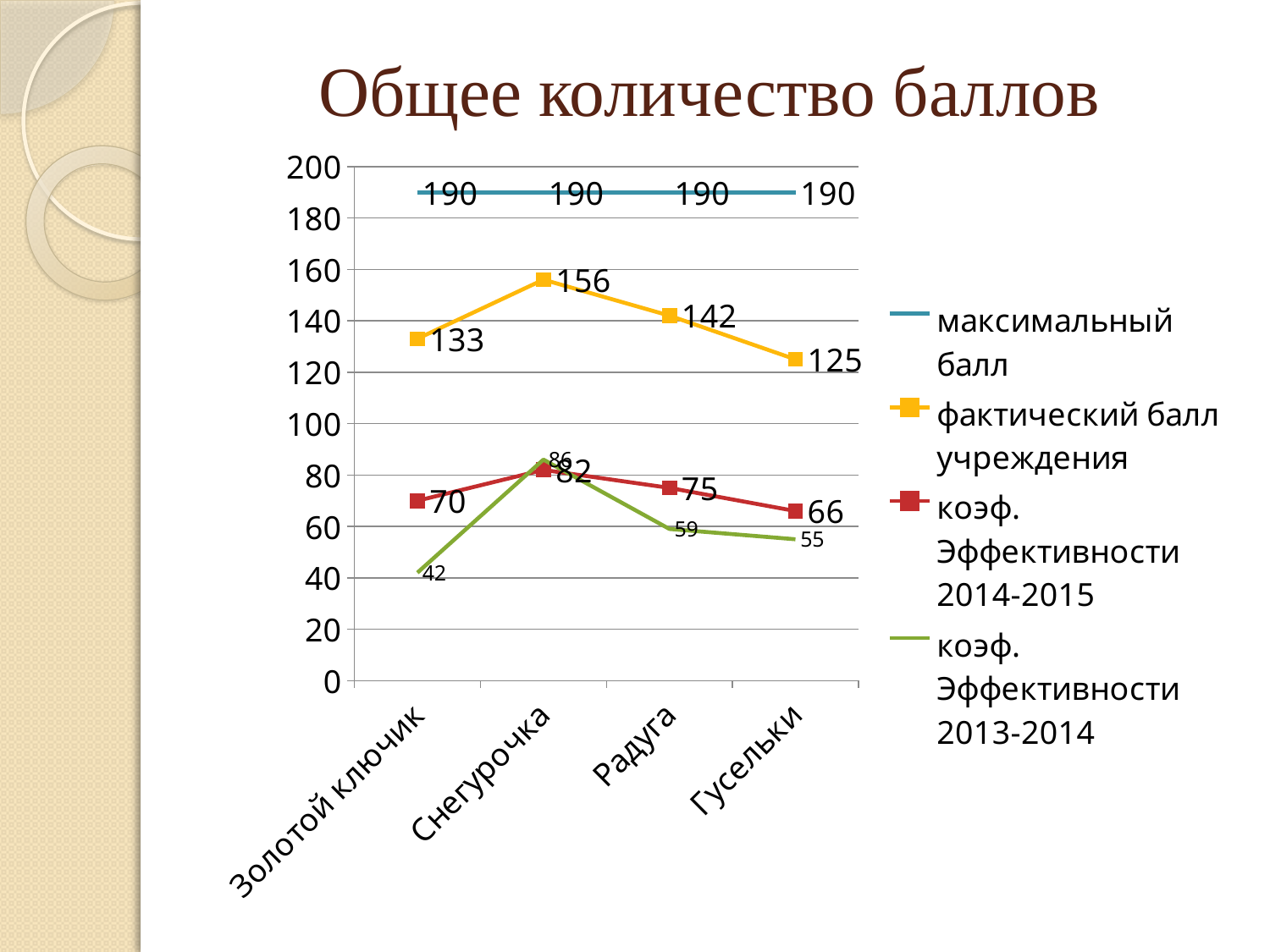
How many series does the legend list? 4 What is the title of the chart? Общее количество баллов How many categories are shown on the x axis? 4 Which category has the highest фактический балл учреждения? Снегурочка How does фактический балл учреждения change from Снегурочка to Гусельки along the x axis? falls What is the value of коэф. Эффективности 2013-2014 for Золотой ключик? 42 What is the value of фактический балл учреждения for Снегурочка? 156 What type of chart is shown on the slide? line chart Which category has the lowest коэф. Эффективности 2014-2015? Гусельки Which is larger for Радуга: коэф. Эффективности 2014-2015 or коэф. Эффективности 2013-2014? коэф. Эффективности 2014-2015 What is the value of максимальный балл for Радуга? 190 What is the difference between фактический балл учреждения for Снегурочка and for Гусельки? 31